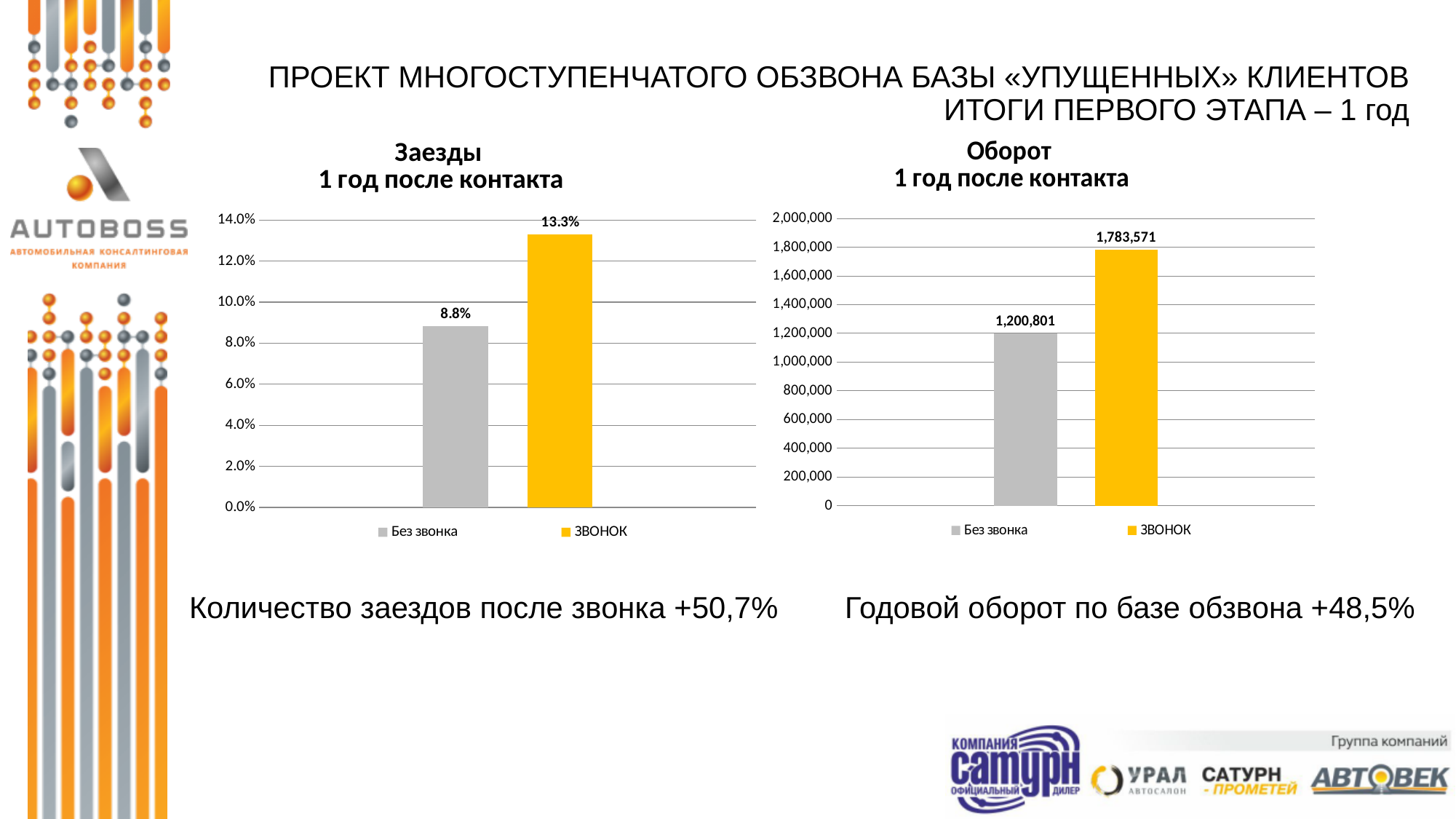
In the chart titled "Заезды 1 год после контакта", what is the value for "Без звонка"? 8.8% What kind of chart is the chart titled "Заезды 1 год после контакта"? Bar chart In the chart titled "Оборот 1 год после контакта", which series has the lower value? Без звонка In the chart titled "Заезды 1 год после контакта", what is the value for "ЗВОНОК"? 13.3% How many series does the legend of the chart titled "Оборот 1 год после контакта" list? 2 In the chart titled "Оборот 1 год после контакта", what is the value for "ЗВОНОК"? 1,783,571 In the chart titled "Оборот 1 год после контакта", is the value for "ЗВОНОК" greater or less than 1,600,000? greater In the chart titled "Оборот 1 год после контакта", what is the difference between the "ЗВОНОК" and "Без звонка" values? 582,770 In the chart titled "Оборот 1 год после контакта", what is the value for "Без звонка"? 1,200,801 In the chart titled "Заезды 1 год после контакта", is the value for "Без звонка" greater or less than 10.0%? less In the chart titled "Заезды 1 год после контакта", which series has the higher value? ЗВОНОК In the chart titled "Заезды 1 год после контакта", what is the difference between the "ЗВОНОК" and "Без звонка" values? 4.5%